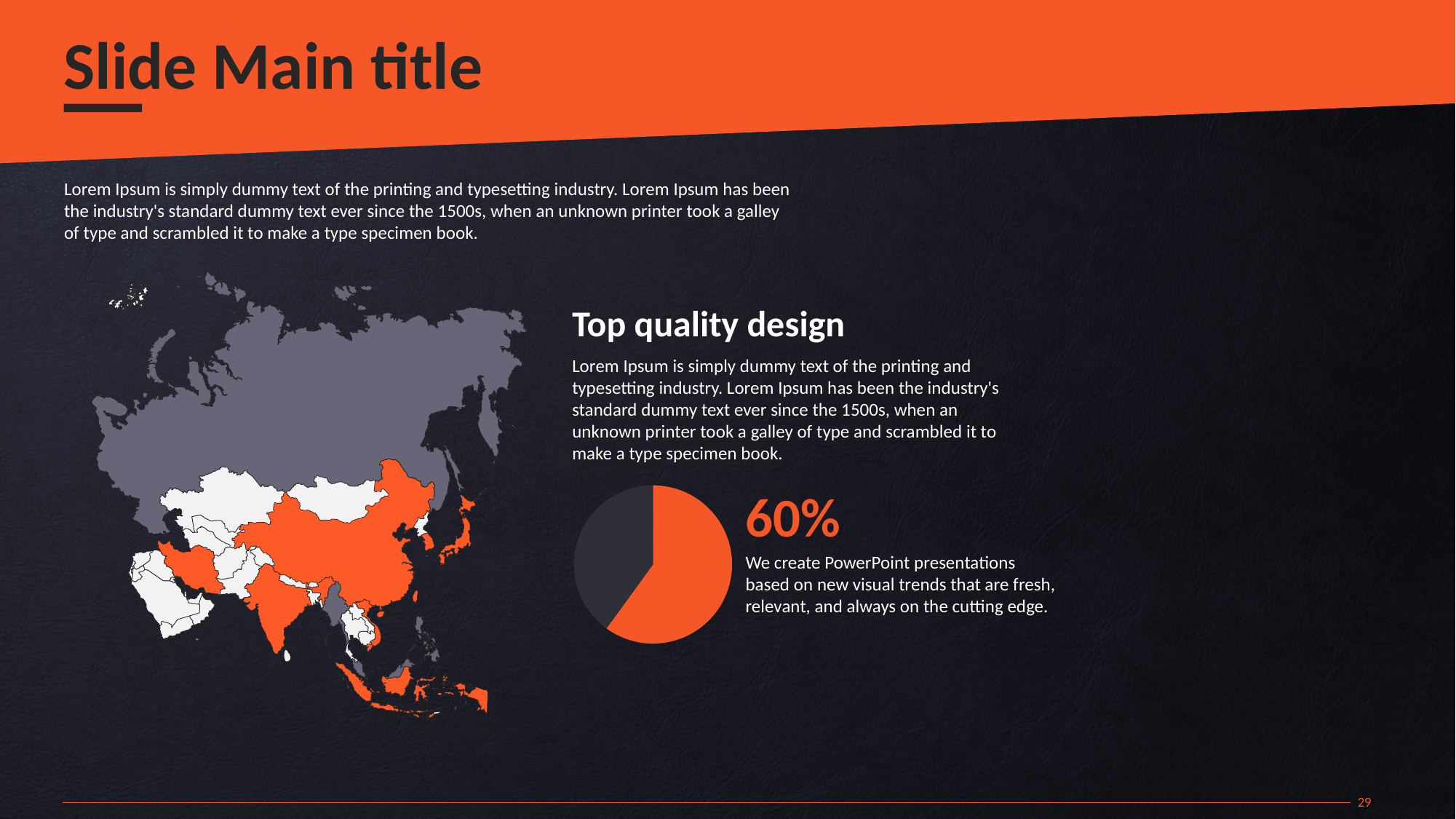
Is the orange slice of the pie chart greater or less than half of the pie? greater How many slices does the pie chart have? 2 Does the pie chart have a legend? No What kind of chart is shown next to the 'Top quality design' text? pie chart What share of the pie chart does the orange slice represent? 60% Which slice of the pie chart is larger, the orange one or the dark grey one? the orange one What share of the pie chart does the dark grey slice represent? 40% What colour is the larger slice of the pie chart? orange What percentage is printed beside the pie chart? 60%